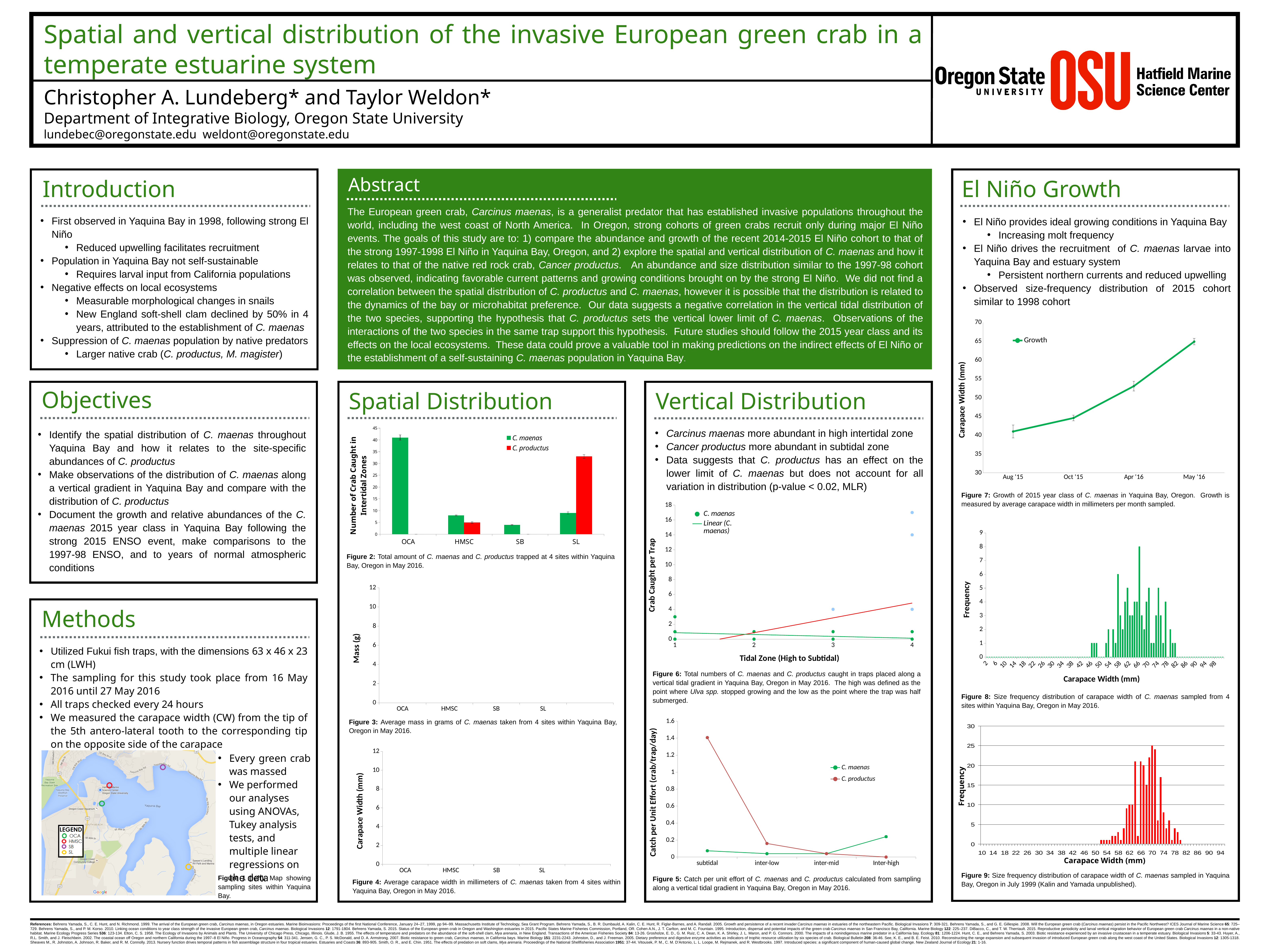
In Figure 2 (Number of Crab Caught in Intertidal Zones), at SL, which species has the larger number caught, C. maenas or C. productus? C. productus In Figure 2 (Number of Crab Caught in Intertidal Zones), is the number of C. maenas caught at OCA greater or less than 35? greater In Figure 2 (Number of Crab Caught in Intertidal Zones), how many series does the legend list? 2 In Figure 9 (Size frequency distribution, July 1999), is the tallest bar's frequency greater or less than 20? greater In Figure 2 (Number of Crab Caught in Intertidal Zones), how many sites are shown on the x axis? 4 In Figure 5 (Catch per Unit Effort chart), is the catch per unit effort for C. productus at subtidal greater or less than 1.2? greater In Figure 5 (Catch per Unit Effort chart), at which tidal zone is the catch per unit effort for C. productus highest? subtidal In Figure 7 (El Niño Growth chart), how many sampling months are plotted on the x axis? 4 In Figure 2 (Spatial Distribution, Number of Crab Caught in Intertidal Zones), what kind of chart is shown? bar chart In Figure 2 (Number of Crab Caught in Intertidal Zones), at which site is the number of C. maenas caught highest? OCA In Figure 7 (El Niño Growth chart), does carapace width rise or fall from Aug '15 to May '16? rise